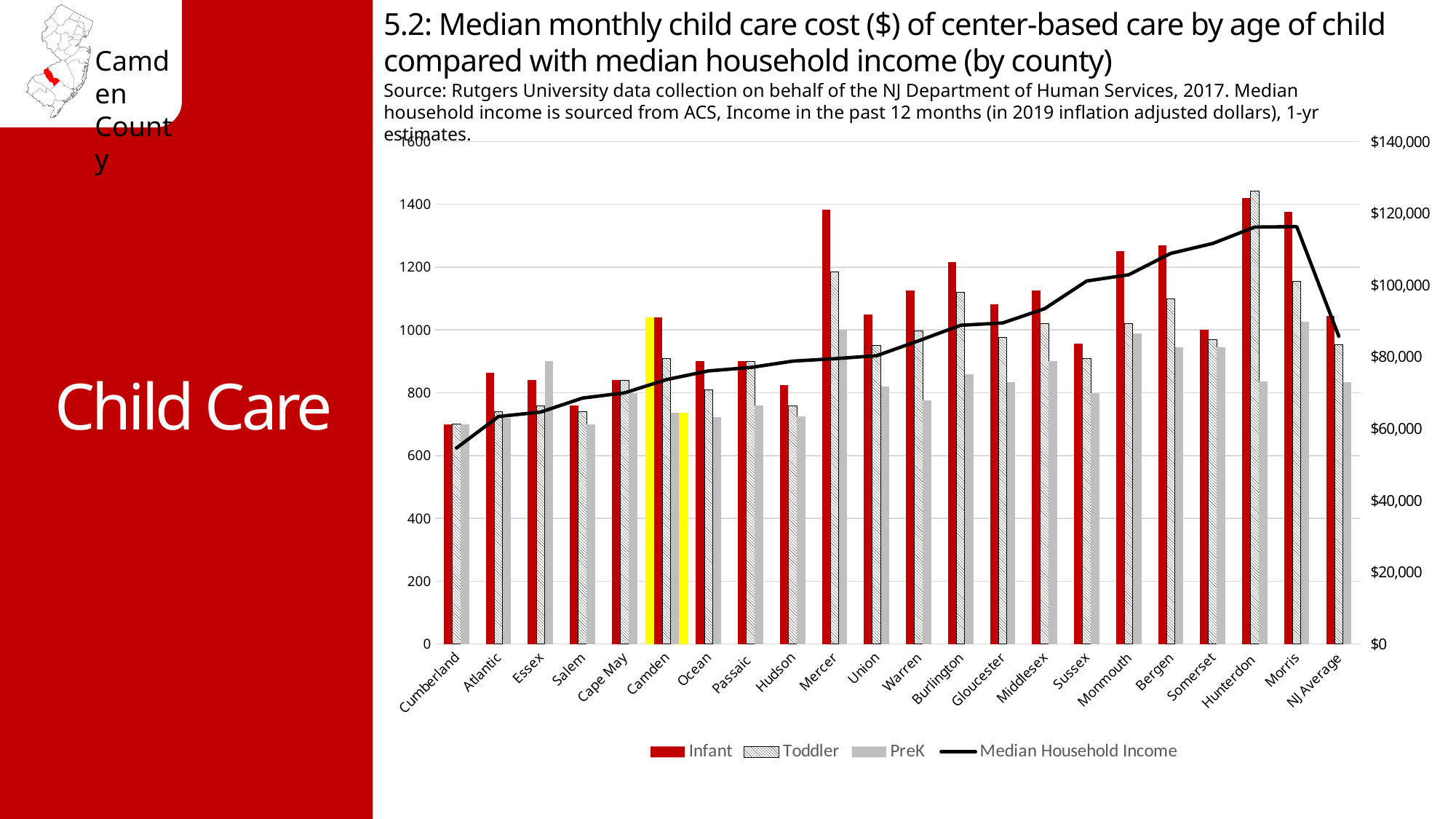
Which county has the lowest Infant child care cost? Cumberland Is the Median Household Income for Cumberland greater or less than $60,000? less How many series does the chart legend list? 4 How many counties/categories are shown along the x axis of the chart? 22 Does the Median Household Income line generally rise or fall from Cumberland to Morris? rise Is the Infant child care cost for Mercer greater or less than 1200? greater Which county has the highest Toddler child care cost? Hunterdon Which county's bars are highlighted in yellow on the chart? Camden Is the Median Household Income for Morris greater or less than $100,000? greater Which is larger, the Infant cost for Mercer or the Infant cost for Camden? Mercer What kind of chart is used to show the child care costs and median household income? Bar chart with a line